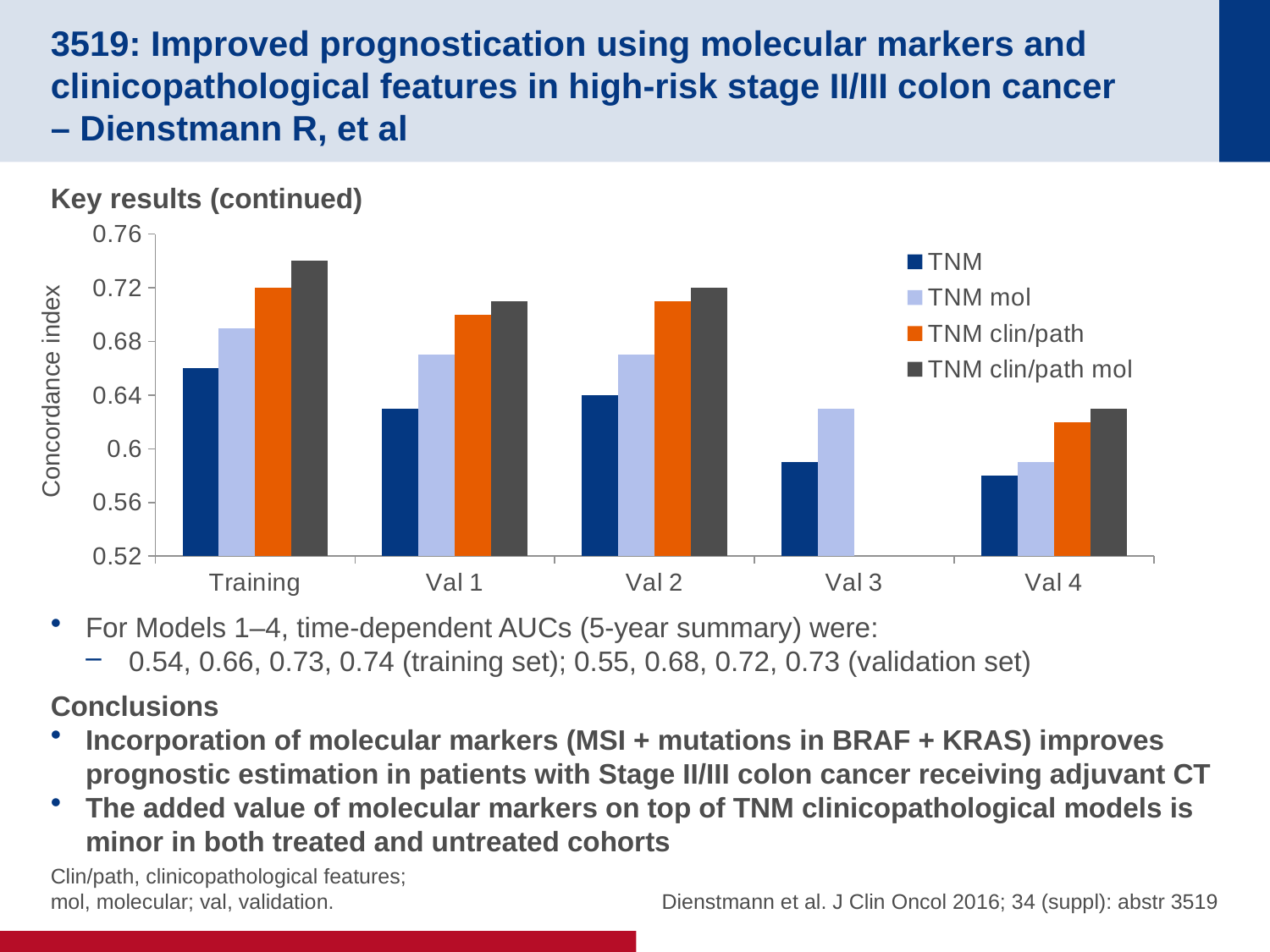
Which is larger, the TNM value for Training or the TNM value for Val 1? Training How many bars are plotted for Val 3? 2 Is the TNM clin/path mol value for Training greater or less than 0.72? greater How many series does the legend list? 4 How many cohort categories are shown on the x axis? 5 Which cohort has the highest TNM clin/path mol concordance index? Training What type of chart is shown on the slide? bar chart Is the TNM value for Val 3 greater or less than 0.6? less What is the TNM concordance index for Val 2? 0.64 Is the TNM clin/path mol value for Val 4 greater or less than 0.6? greater Which cohort has the lowest TNM concordance index? Val 4 What is the label of the y axis? Concordance index